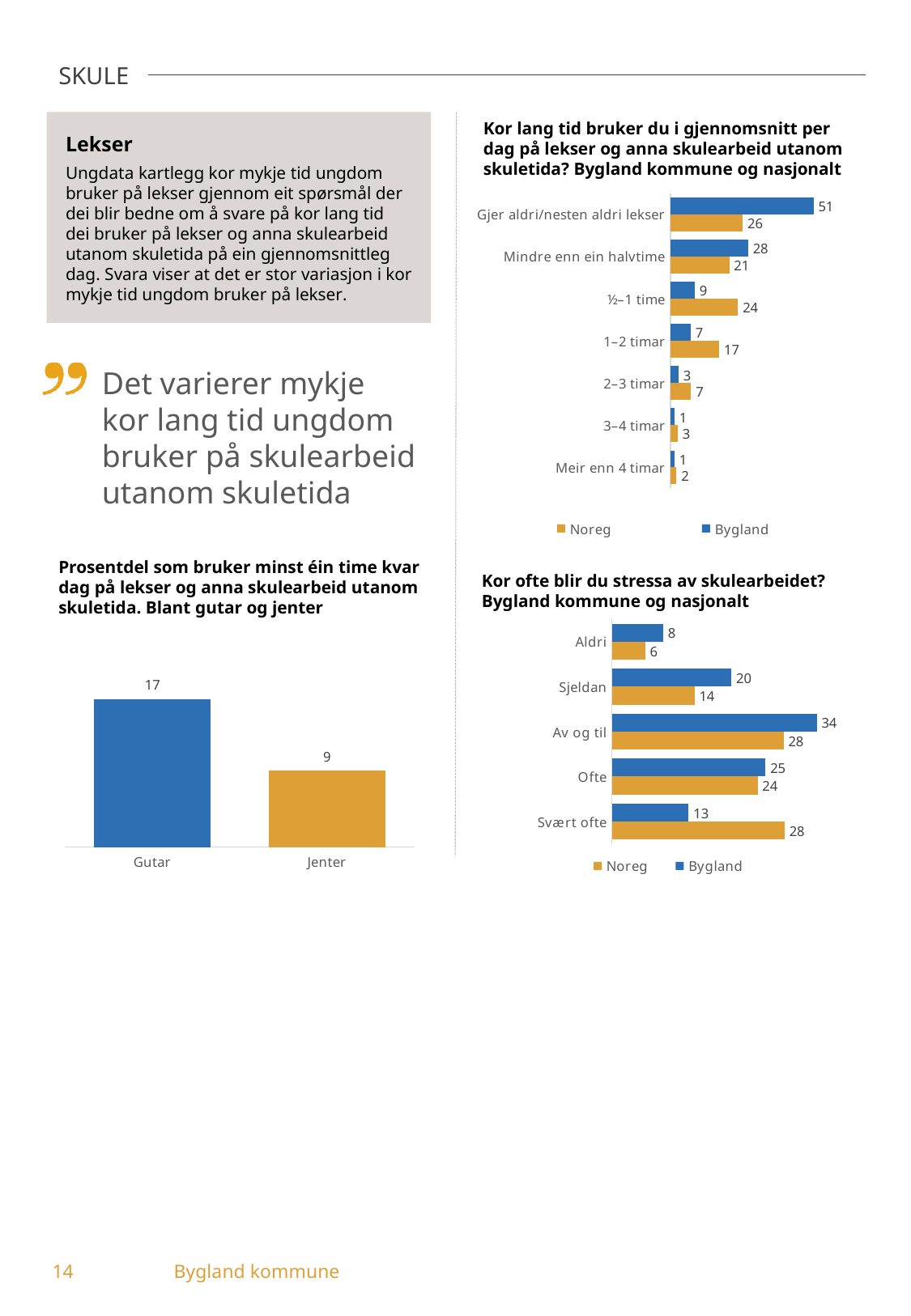
In the chart 'Kor ofte blir du stressa av skulearbeidet?', which is larger for 'Sjeldan': Bygland or Noreg? Bygland In the chart 'Prosentdel som bruker minst éin time kvar dag på lekser og anna skulearbeid utanom skuletida', what is the value for Gutar? 17 In the chart 'Kor ofte blir du stressa av skulearbeidet?', what is the Noreg value for 'Svært ofte'? 28 In the chart 'Kor lang tid bruker du i gjennomsnitt per dag på lekser og anna skulearbeid utanom skuletida?', what is the difference between the Bygland and Noreg values for 'Gjer aldri/nesten aldri lekser'? 25 In the chart 'Kor lang tid bruker du i gjennomsnitt per dag på lekser og anna skulearbeid utanom skuletida?', how many categories are shown? 7 In the chart 'Kor ofte blir du stressa av skulearbeidet?', which category has the highest Bygland value? Av og til What kind of chart is 'Prosentdel som bruker minst éin time kvar dag på lekser og anna skulearbeid utanom skuletida'? Bar chart In the chart 'Kor lang tid bruker du i gjennomsnitt per dag på lekser og anna skulearbeid utanom skuletida?', what is the Bygland value for 'Gjer aldri/nesten aldri lekser'? 51 In the chart 'Kor lang tid bruker du i gjennomsnitt per dag på lekser og anna skulearbeid utanom skuletida?', which category has the highest Noreg value? Gjer aldri/nesten aldri lekser In the chart 'Kor lang tid bruker du i gjennomsnitt per dag på lekser og anna skulearbeid utanom skuletida?', what is the Noreg value for '½–1 time'? 24 How many series does the legend list in the chart 'Kor ofte blir du stressa av skulearbeidet?'? 2 In the chart 'Prosentdel som bruker minst éin time kvar dag på lekser og anna skulearbeid utanom skuletida', what is the difference between Gutar and Jenter? 8